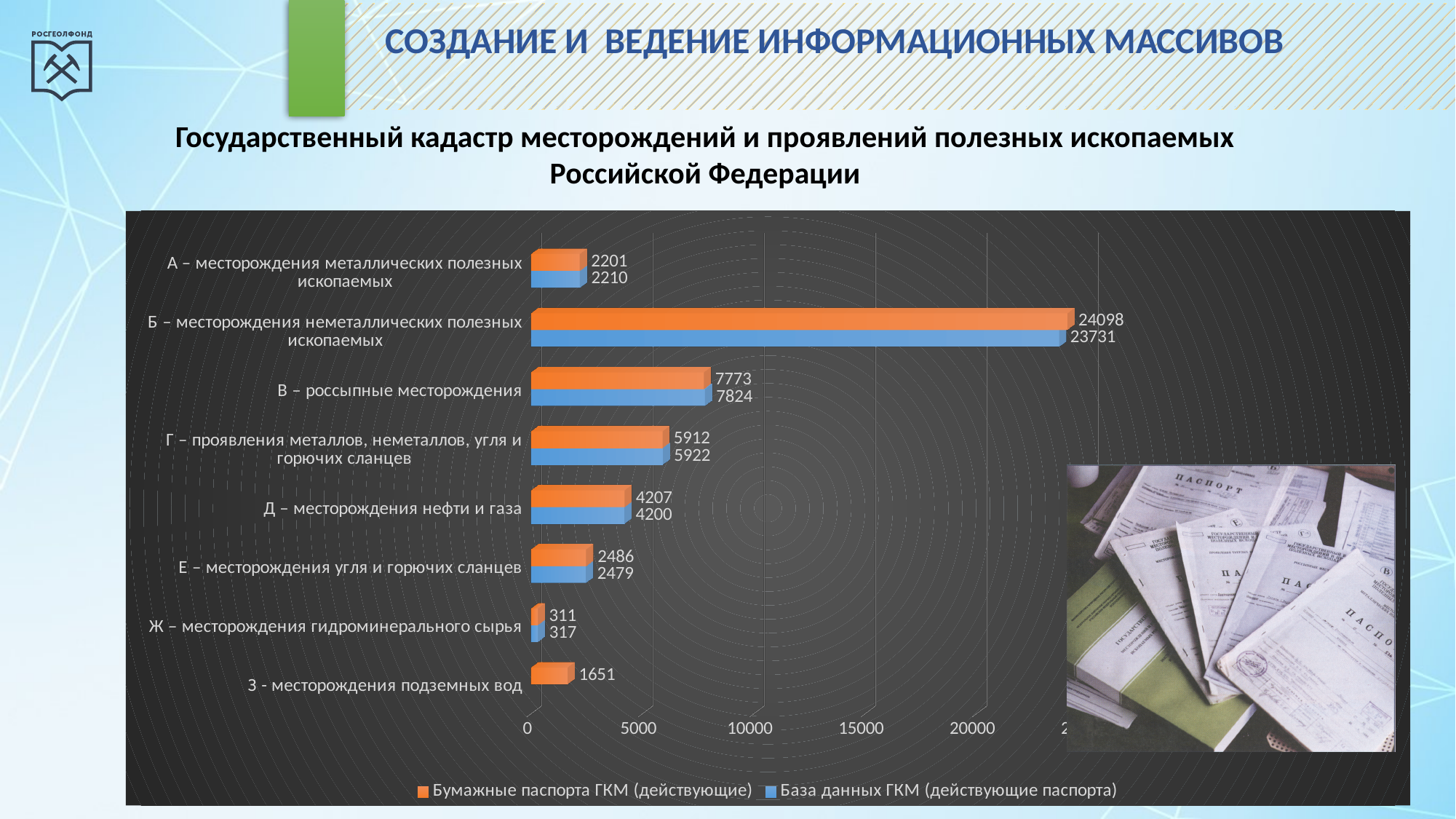
How many categories are shown on the chart? 8 Which is larger for 'Д – месторождения нефти и газа': 'Бумажные паспорта ГКМ (действующие)' or 'База данных ГКМ (действующие паспорта)'? Бумажные паспорта ГКМ (действующие) Which colour represents the series 'База данных ГКМ (действующие паспорта)' in the legend? blue How many series does the legend list? 2 Which category has the lowest value for 'База данных ГКМ (действующие паспорта)'? Ж – месторождения гидроминерального сырья Which category has the highest value for 'Бумажные паспорта ГКМ (действующие)'? Б – месторождения неметаллических полезных ископаемых What is the difference between 'Бумажные паспорта ГКМ (действующие)' and 'База данных ГКМ (действующие паспорта)' for 'Б – месторождения неметаллических полезных ископаемых'? 367 Is the value of 'Бумажные паспорта ГКМ (действующие)' for 'Г – проявления металлов, неметаллов, угля и горючих сланцев' greater or less than 5000? greater What is the value of 'Бумажные паспорта ГКМ (действующие)' for 'З - месторождения подземных вод'? 1651 What is the value of 'База данных ГКМ (действующие паспорта)' for 'В – россыпные месторождения'? 7824 What kind of chart is shown on the slide? bar chart What is the value of 'Бумажные паспорта ГКМ (действующие)' for 'Б – месторождения неметаллических полезных ископаемых'? 24098